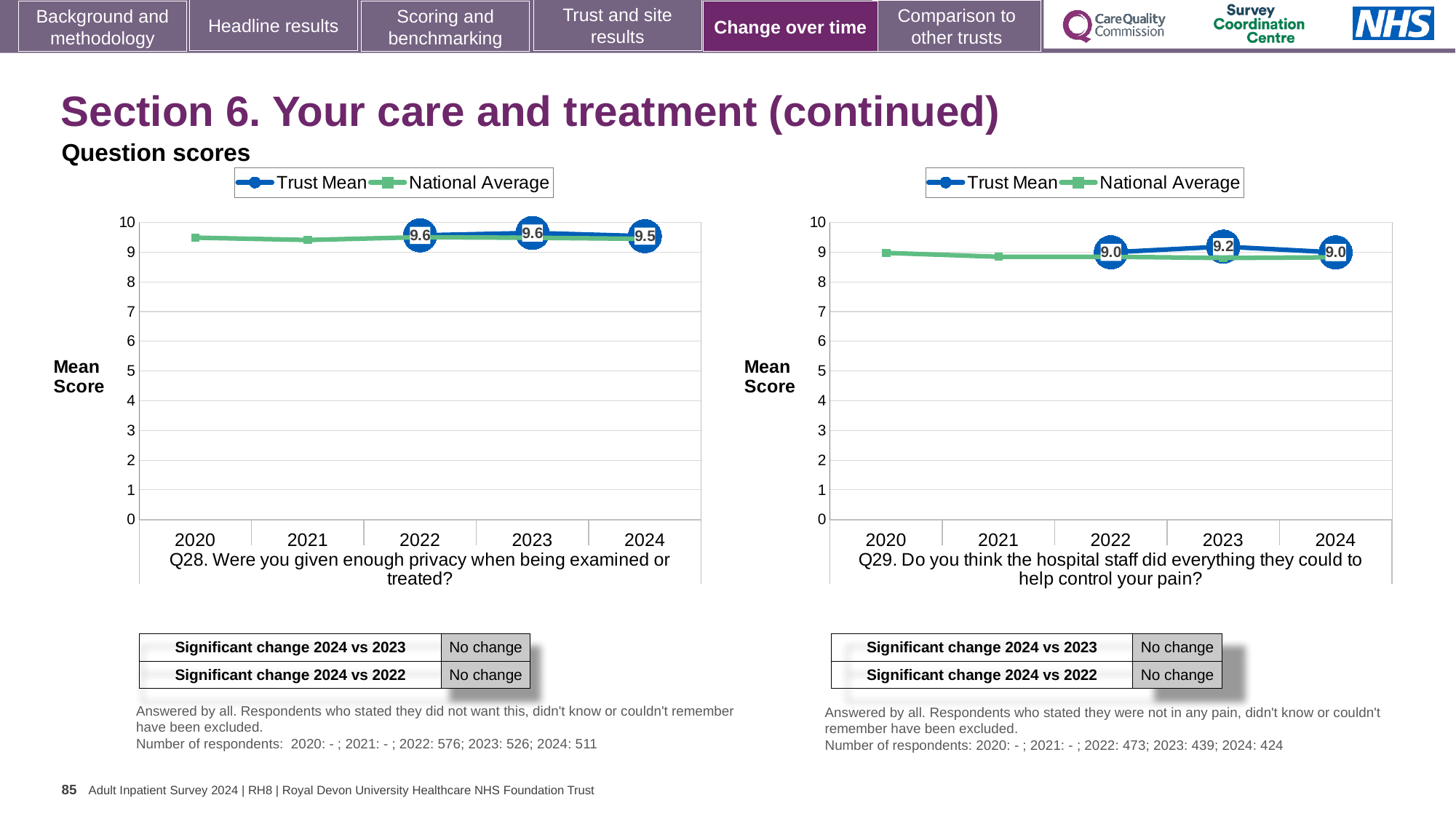
In the Q28 chart (left), which year has the lowest labelled Trust Mean score? 2024 What type of chart is the Q29 chart (right)? Line chart In the Q29 chart (right), what is the Trust Mean score for 2023? 9.2 In the Q29 chart (right), what is the Trust Mean score for 2024? 9.0 In the Q29 chart (right), which year has the highest Trust Mean score? 2023 How many years are shown on the x axis of the Q29 chart (right)? 5 In the Q28 chart (left), what is the Trust Mean score for 2024? 9.5 How many series does the legend of the Q28 chart (left) list? 2 In the Q28 chart (left), which is larger, the Trust Mean for 2023 or for 2024? 2023 In the Q28 chart (left), what is the Trust Mean score for 2022? 9.6 In the Q29 chart (right), what is the difference between the Trust Mean scores for 2023 and 2024? 0.2 In the Q28 chart (left), is the National Average for 2020 greater or less than 9? greater